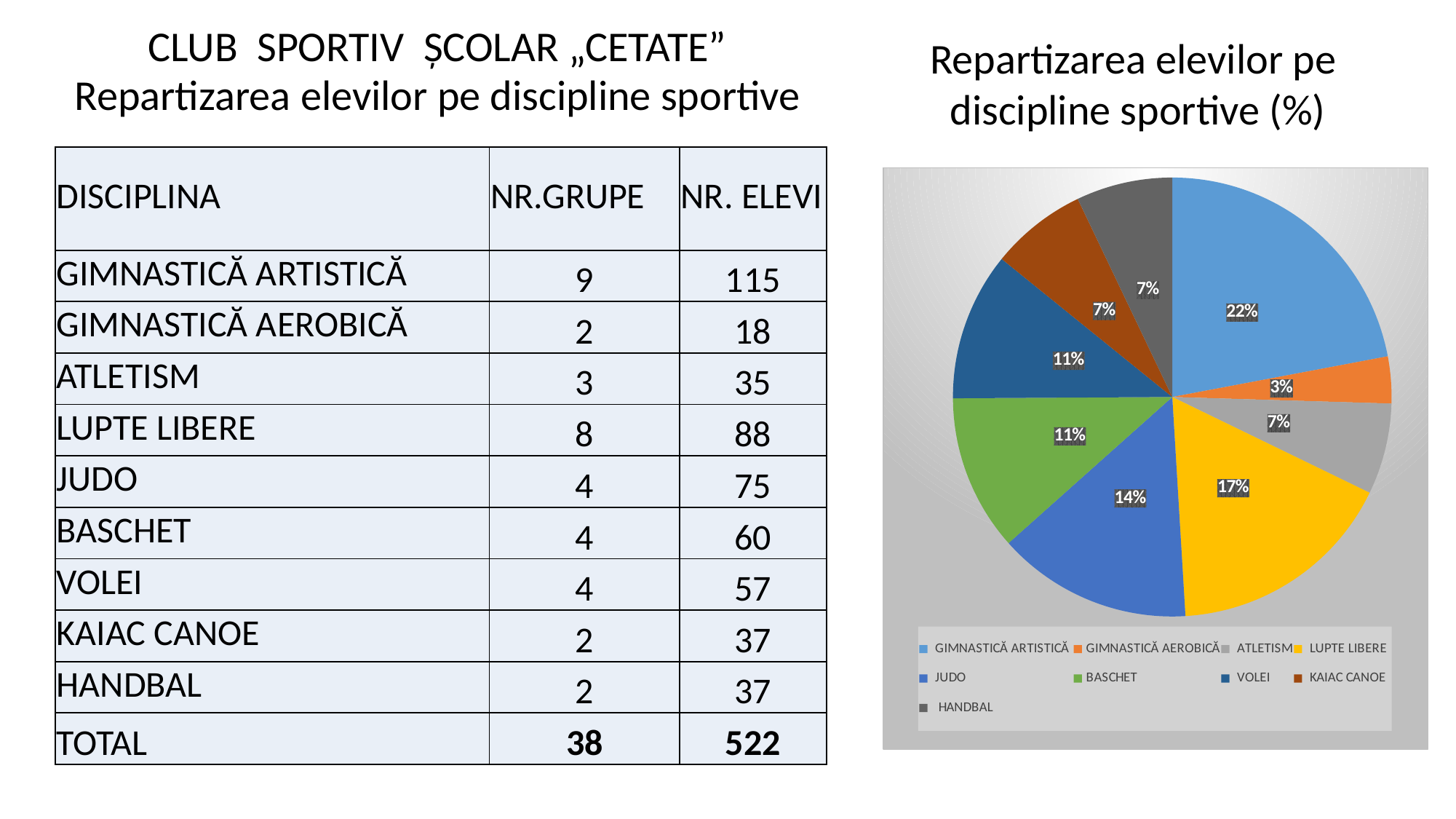
How many disciplines does the pie chart's legend list? 9 Which discipline has the largest slice in the pie chart? GIMNASTICĂ ARTISTICĂ Which discipline has the smallest slice in the pie chart? GIMNASTICĂ AEROBICĂ In the pie chart, what share does LUPTE LIBERE have? 17% In the pie chart, what share does JUDO have? 14% In the pie chart, which is larger, the share for JUDO or the share for ATLETISM? JUDO In the pie chart, what is the difference in percentage points between GIMNASTICĂ ARTISTICĂ and LUPTE LIBERE? 5 What type of chart is shown on the right side of the slide? pie chart In the pie chart, what share does BASCHET have? 11% What is the title of the pie chart? Repartizarea elevilor pe discipline sportive (%)